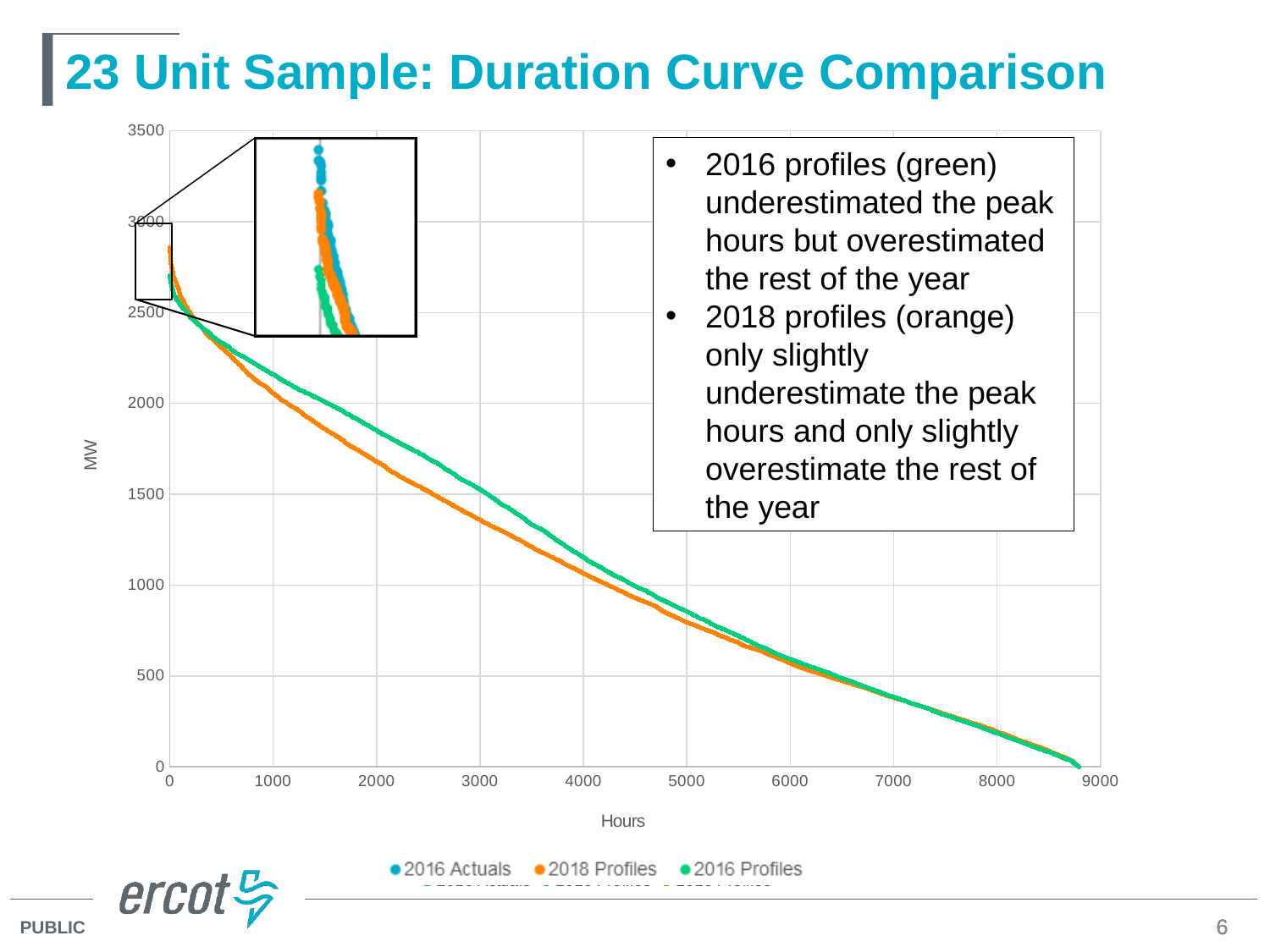
How many series does the legend list? 3 At 1000 hours, is the value for 2016 Profiles greater or less than 1500 MW? greater What is the label of the y axis? MW At 5000 hours, is the value for 2016 Profiles greater or less than 1000 MW? less At 2000 hours, which series has the higher MW value, 2016 Profiles or 2018 Profiles? 2016 Profiles Do the MW values rise or fall as Hours increase along the x axis? Fall What kind of chart is shown on the slide? Scatter (line) chart At 7000 hours, is the value for 2018 Profiles greater or less than 500 MW? less Which series is plotted in green? 2016 Profiles